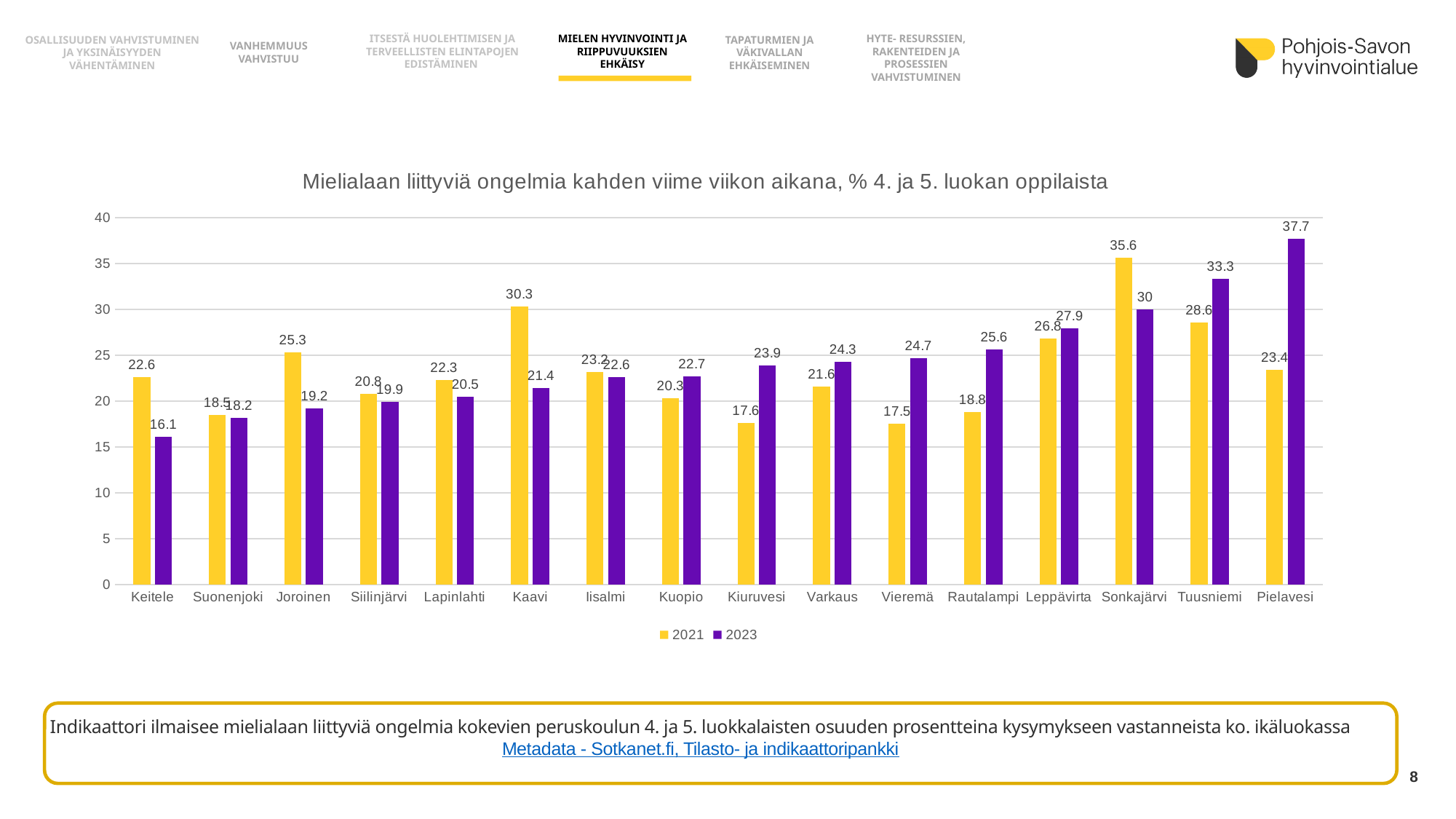
How many series does the legend list? 2 Which colour represents the 2023 series? Purple How many municipalities are shown on the x axis? 16 Which municipality has the highest 2021 value? Sonkajärvi What is the 2021 value for Kaavi? 30.3 Which is larger for Keitele, the 2021 value or the 2023 value? 2021 Is the 2023 value for Tuusniemi greater or less than 30? greater What is the difference between the 2023 and 2021 values for Pielavesi? 14.3 Which municipality has the lowest 2023 value? Keitele What kind of chart is shown on the slide? Bar chart What is the 2023 value for Sonkajärvi? 30 What is the 2023 value for Pielavesi? 37.7